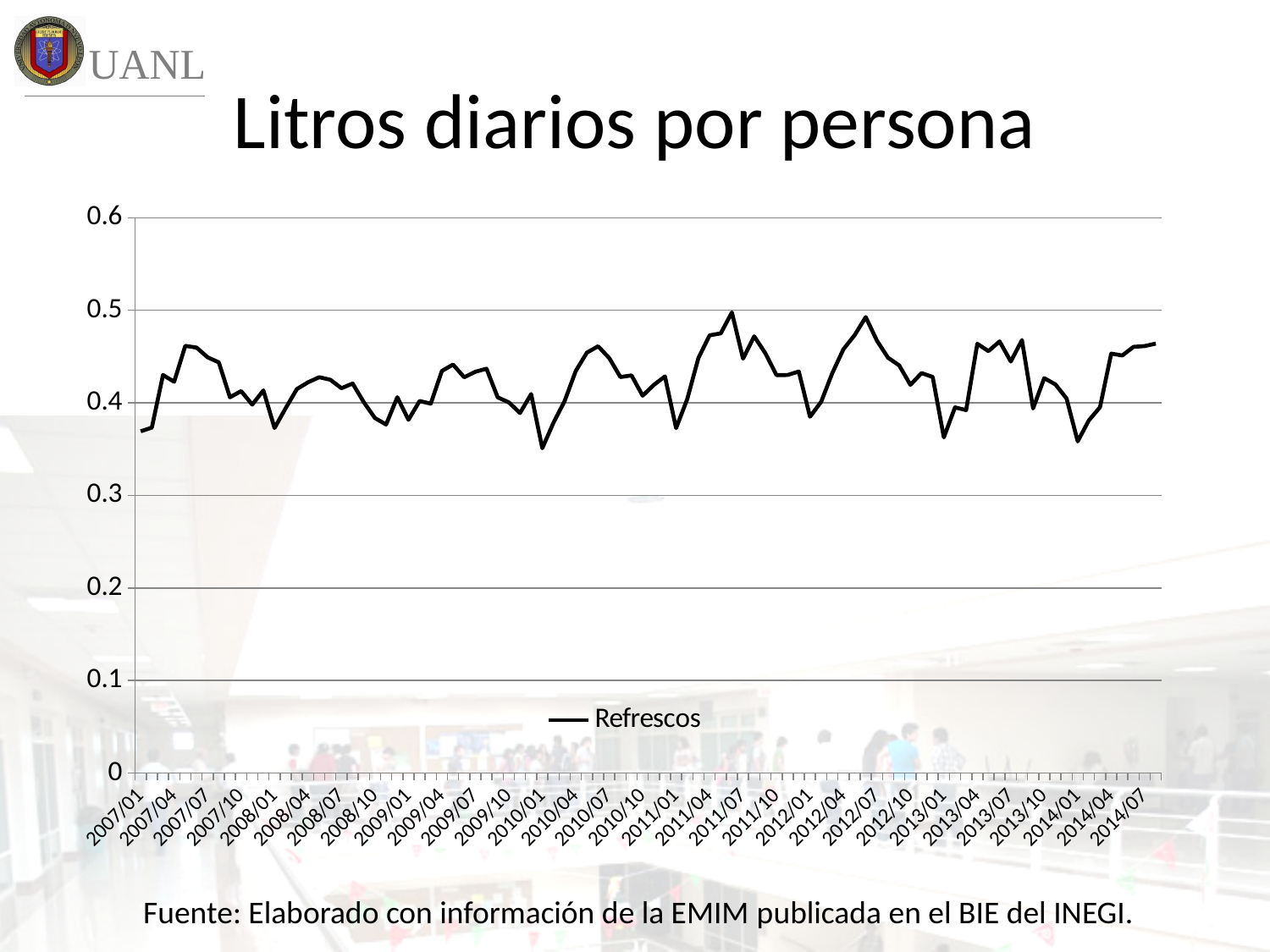
What is the title of the chart? Litros diarios por persona What kind of chart is shown on the slide? line chart Which is larger, the value for 2007/01 or the value for 2007/07? 2007/07 How many series does the legend list? 1 Is the value for 2012/07 greater or less than 0.4? greater Is the value for 2014/01 greater or less than 0.4? less Is the value for 2011/07 greater or less than 0.4? greater Which is larger, the value for 2011/07 or the value for 2010/01? 2011/07 What is the name of the series shown in the legend? Refrescos